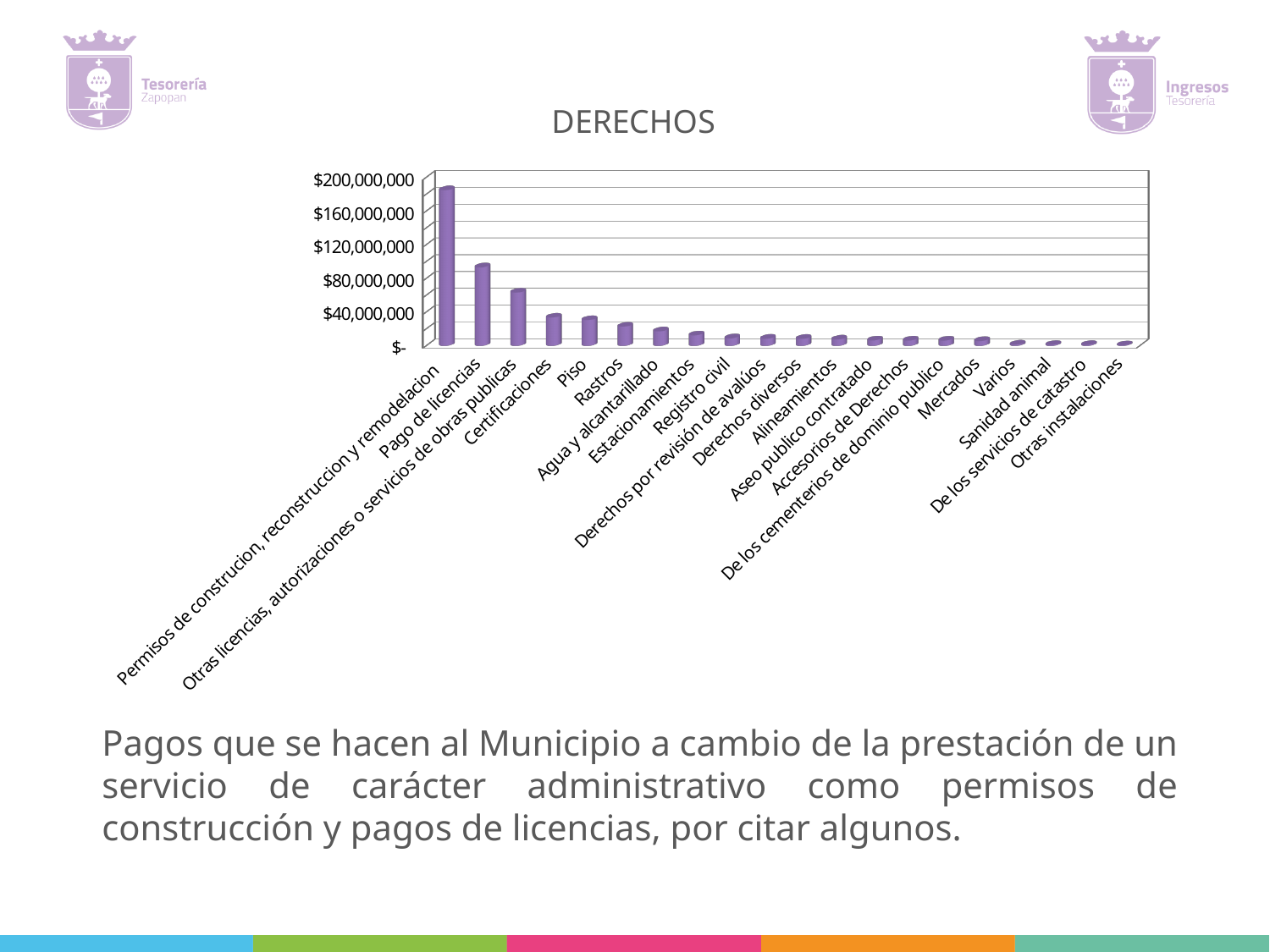
Which category has the highest value in the chart? Permisos de construcion, reconstruccion y remodelacion What kind of chart is shown on the slide? bar chart Is the value for Permisos de construcion, reconstruccion y remodelacion greater or less than $160,000,000? greater How many categories are plotted in the chart? 20 Which is larger, the value for Certificaciones or the value for Rastros? Certificaciones What is the title of the chart? DERECHOS Do the values generally rise or fall moving from left to right along the x axis? fall Is the value for Otras licencias, autorizaciones o servicios de obras publicas greater or less than $40,000,000? greater Which is larger, the value for Pago de licencias or the value for Otras licencias, autorizaciones o servicios de obras publicas? Pago de licencias Is the value for Pago de licencias greater or less than $120,000,000? less